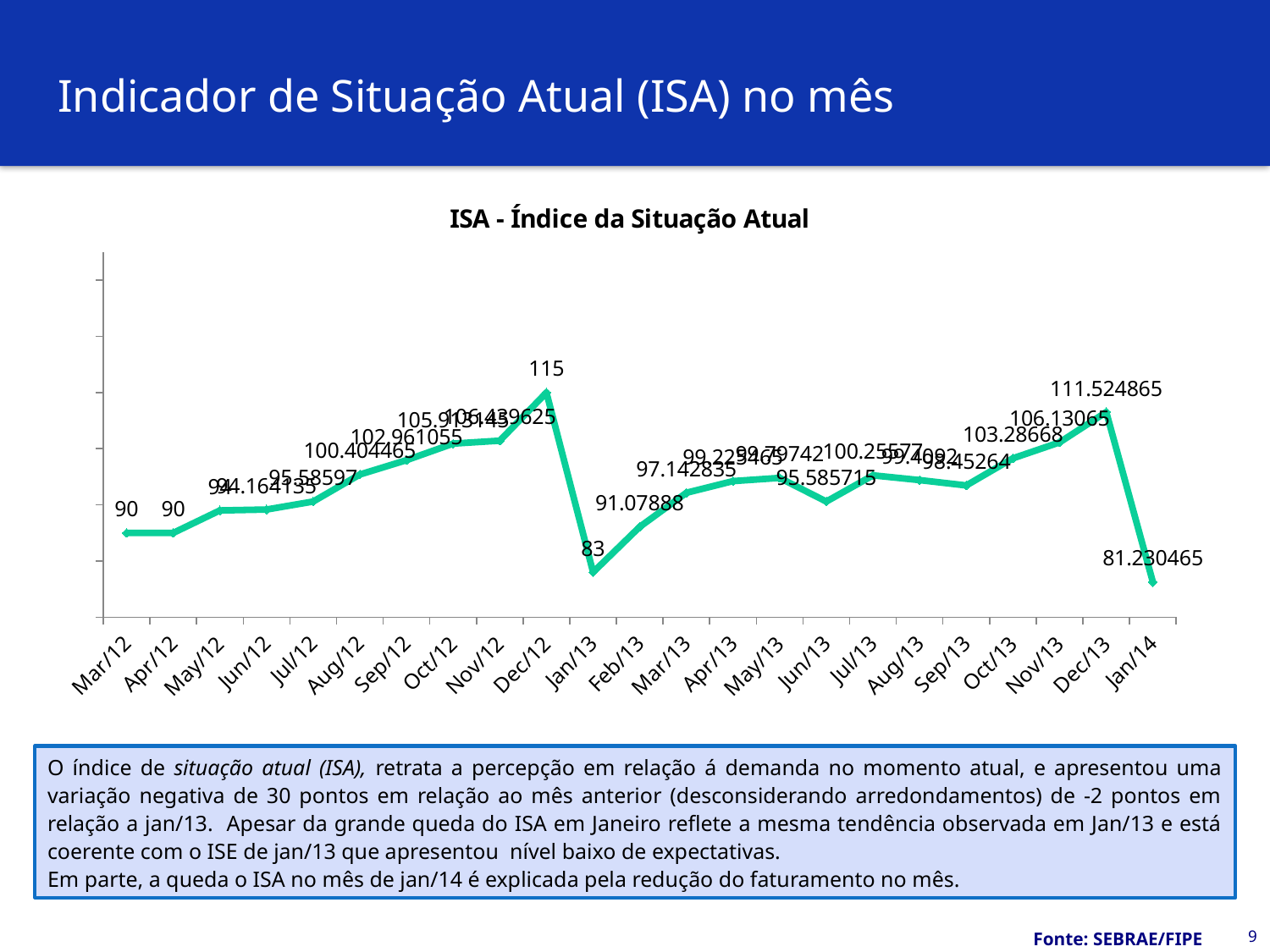
Which month has the highest ISA value? Dec/12 How many months are plotted on the x axis? 23 Which is larger, the ISA value for Dec/12 or for Dec/13? Dec/12 What is the difference between the ISA values for Dec/12 and Jan/13? 32 What is the ISA value for Jan/13? 83 What type of chart is shown on the slide? Line chart What is the title of the chart? ISA - Índice da Situação Atual What is the ISA value for Mar/12? 90 What is the ISA value for Dec/12? 115 Which month has the lowest ISA value? Jan/14 What is the ISA value for Jan/14? 81.230465 What is the ISA value for Dec/13? 111.524865